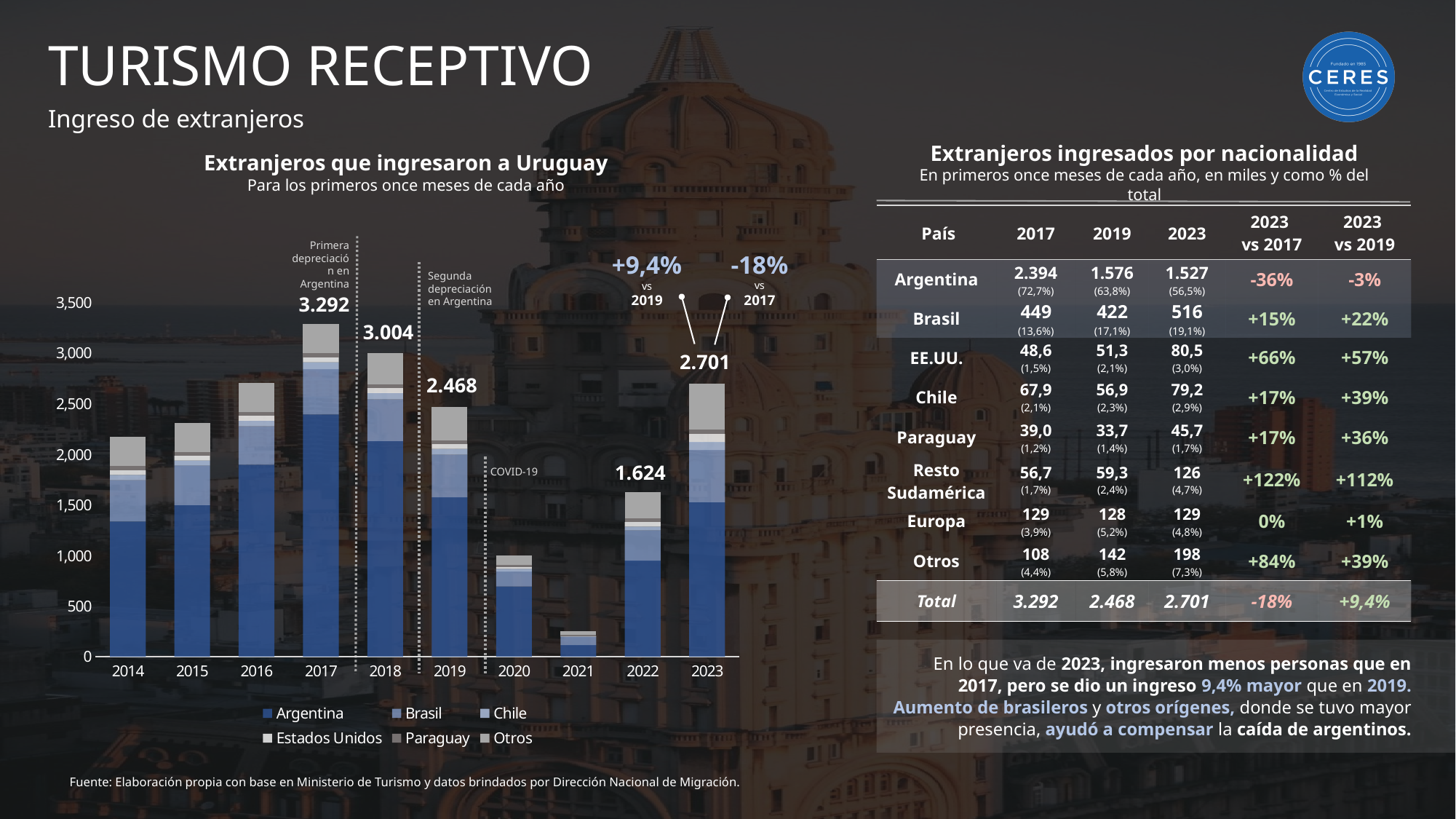
Is the total value for 2021 greater or less than 500? less Which year has the lowest total bar in the chart? 2021 Which year has a larger total, 2018 or 2019? 2018 What is the total value labelled on the 2019 bar? 2.468 What is the total value labelled on the 2022 bar? 1.624 How many series does the chart legend list? 6 What kind of chart is used to show foreigners entering Uruguay? Stacked bar chart What is the difference between the 2017 total (3.292) and the 2023 total (2.701)? 591 Which year has the highest total bar in the chart? 2017 What is the total value shown for the 2023 bar in the chart? 2.701 What is the total number of foreigners who entered Uruguay in 2017 according to the chart? 3.292 How many years are shown on the x axis of the chart? 10